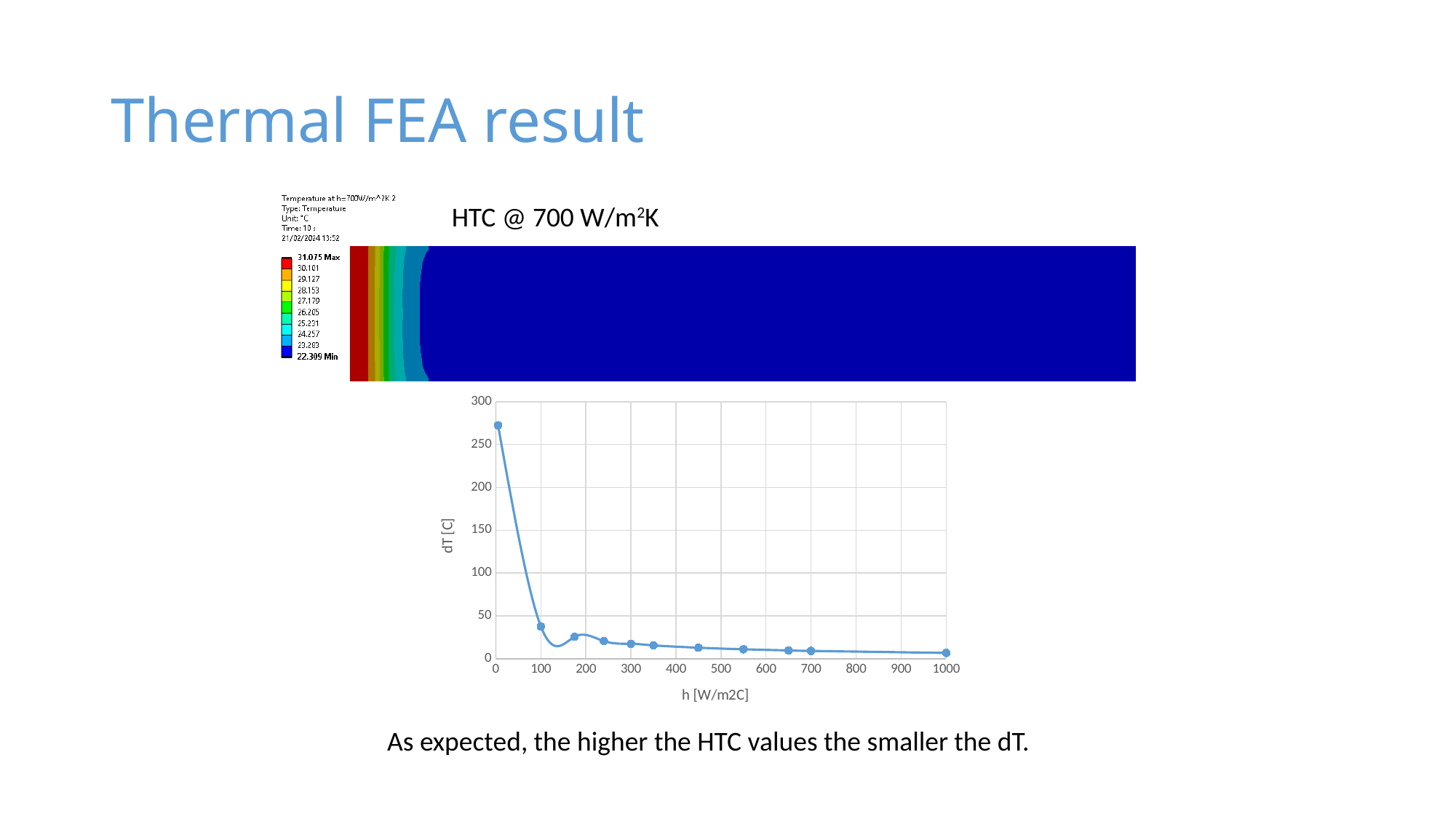
Which has the larger dT: h = 100 or h = 1000? h = 100 What kind of chart is shown on the slide? Line chart Is the value of dT at h = 100 greater or less than 50? less How does dT change as h increases along the x axis? It falls What is the maximum value of the x axis shown on the line chart? 1000 How many data points are plotted on the line chart? 11 Is the value of dT at h = 1000 greater or less than 50? less Is the value of dT at h = 300 greater or less than 100? less What is the label of the y axis of the line chart? dT [C] What is the label of the x axis of the line chart? h [W/m2C]